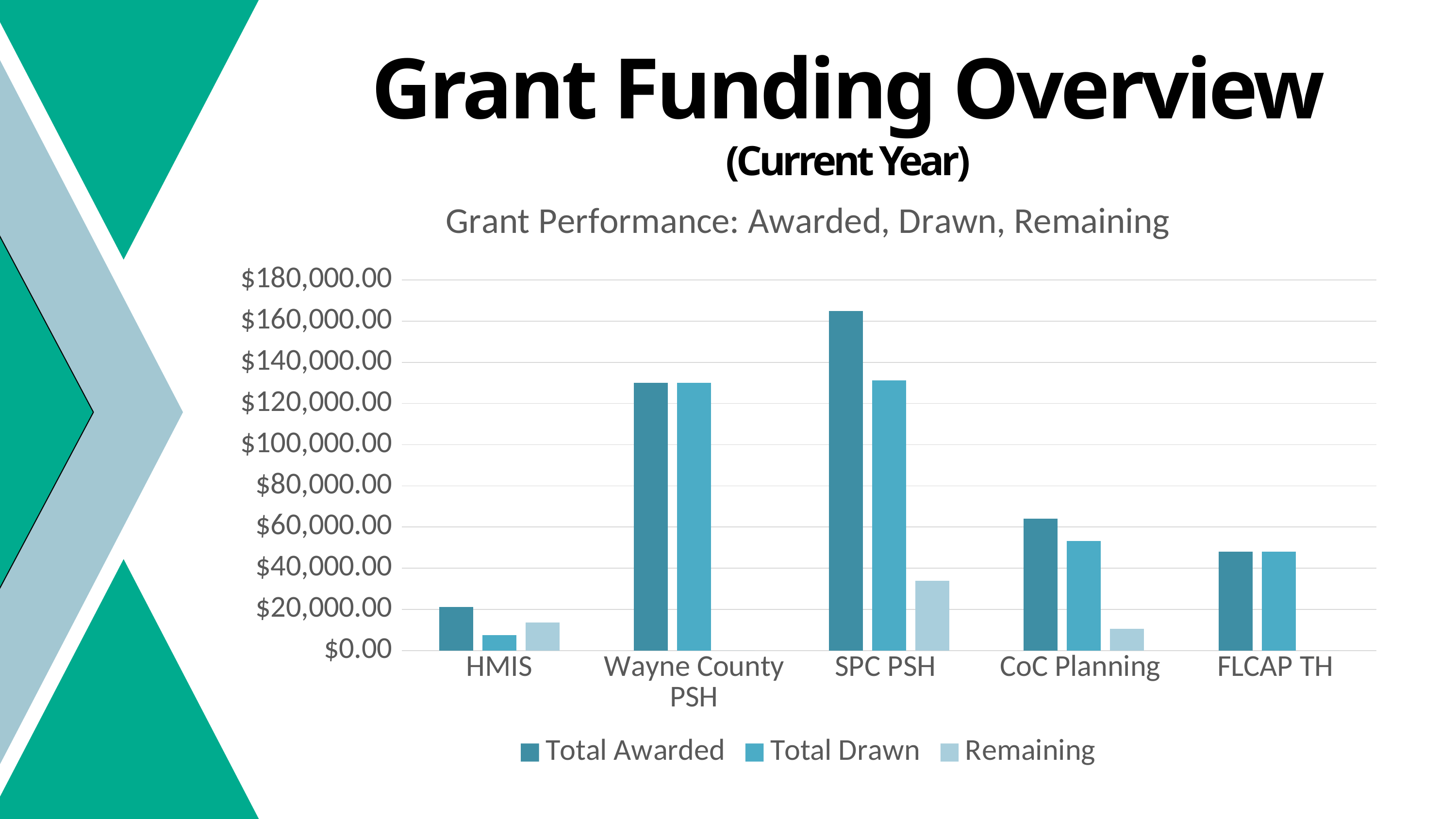
Is the Remaining value for SPC PSH greater or less than $40,000.00? less Is the Total Awarded value for Wayne County PSH greater or less than $120,000.00? greater Which is larger: the Total Awarded value for CoC Planning or for FLCAP TH? CoC Planning Which grant has the largest Remaining value? SPC PSH Is the Total Drawn value for HMIS greater or less than $20,000.00? less Which grant has the lowest Total Awarded value? HMIS Which grant has the highest Total Awarded value? SPC PSH How many series does the legend list? 3 How many grant categories are shown on the x axis? 5 What kind of chart is shown on the slide? Bar chart What is the title of the chart? Grant Performance: Awarded, Drawn, Remaining